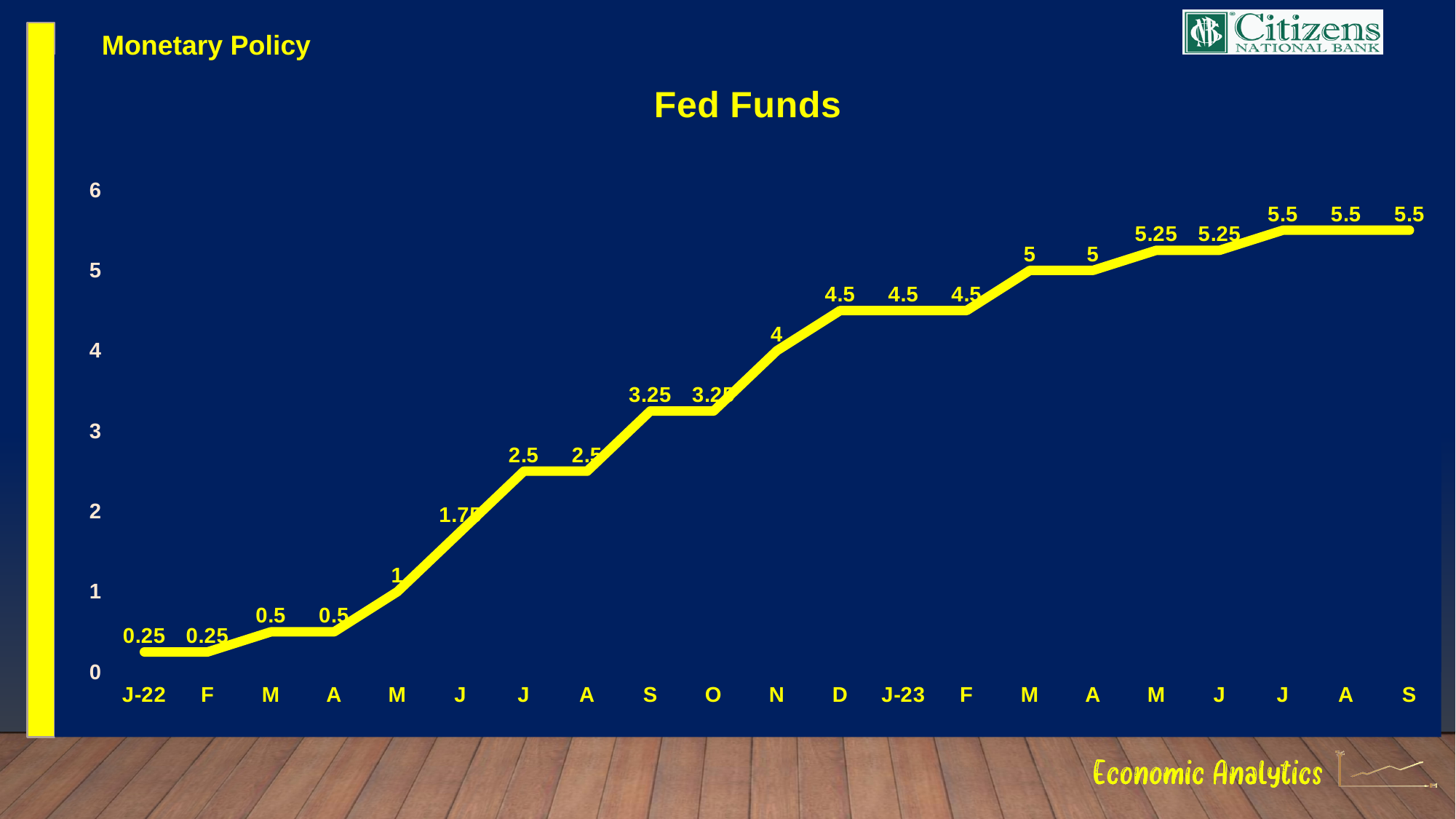
How many data points are plotted on the chart? 21 What is the title of the chart? Fed Funds What is the Fed Funds value at J-22? 0.25 What is the lowest Fed Funds value shown on the chart? 0.25 What is the highest Fed Funds value shown on the chart? 5.5 What is the Fed Funds value at N (November 2022)? 4 Which is larger, the Fed Funds value at D (December 2022) or at N (November 2022)? D (December 2022) What type of chart is shown on the slide? line chart What is the difference between the Fed Funds value at the last point (S, September 2023) and at J-22? 5.25 What is the Fed Funds value at J-23? 4.5 What is the Fed Funds value at the last point on the chart (S, September 2023)? 5.5 What is the Fed Funds value at O (October 2022)? 3.25